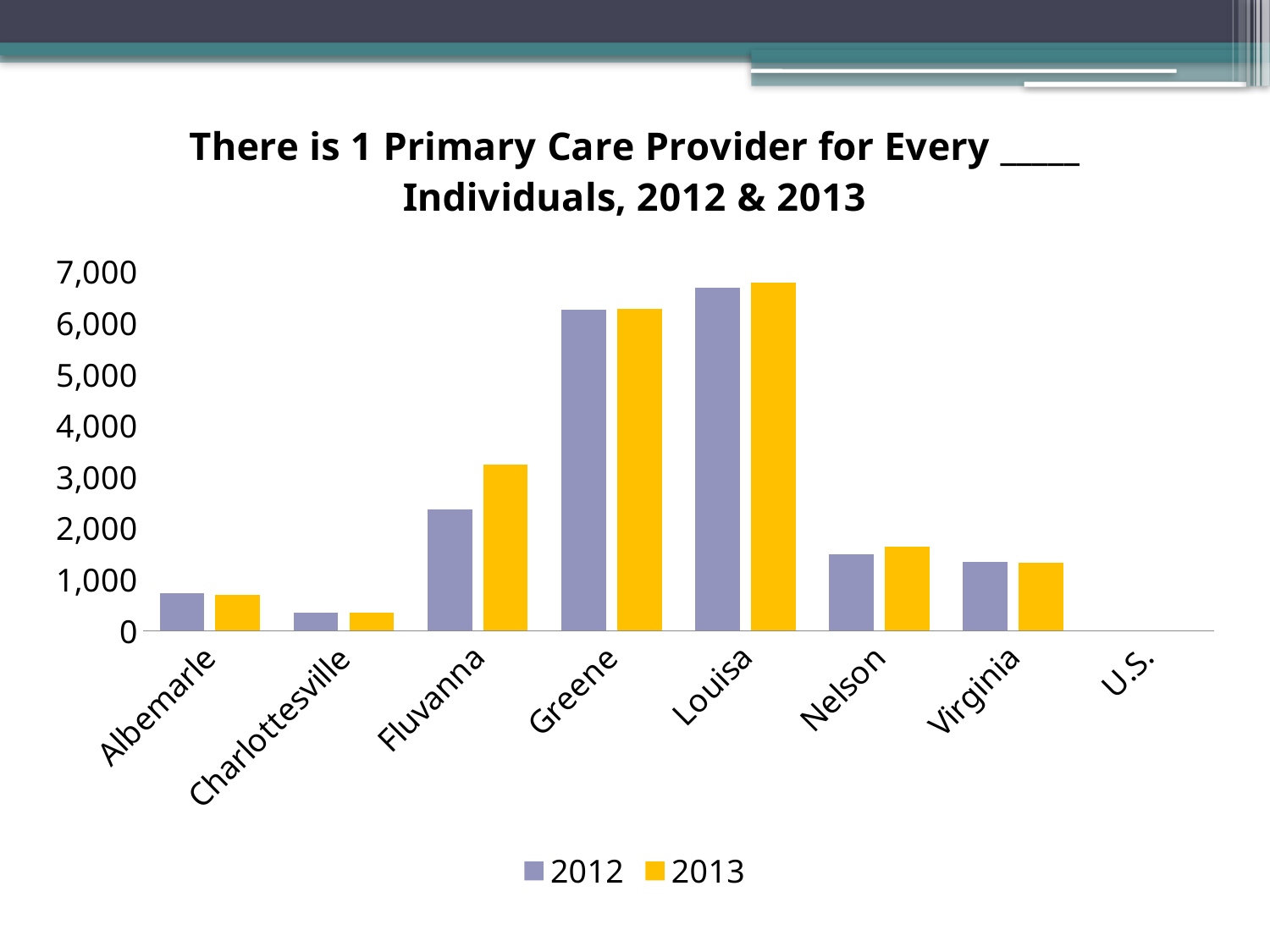
How many categories are shown along the x axis? 8 Which category has the highest value for 2013? Louisa Which category has the highest value for 2012? Louisa Which colour represents the 2013 series in the legend? yellow Is the 2013 value for Albemarle greater or less than 1,000? less Is the 2012 value for Greene greater or less than 6,000? greater Is the 2013 value for Fluvanna greater or less than 3,000? greater What kind of chart is shown on the slide? bar chart Among the categories with bars, which has the lowest value for 2012? Charlottesville For Fluvanna, which year has the larger value, 2012 or 2013? 2013 How many series does the legend list? 2